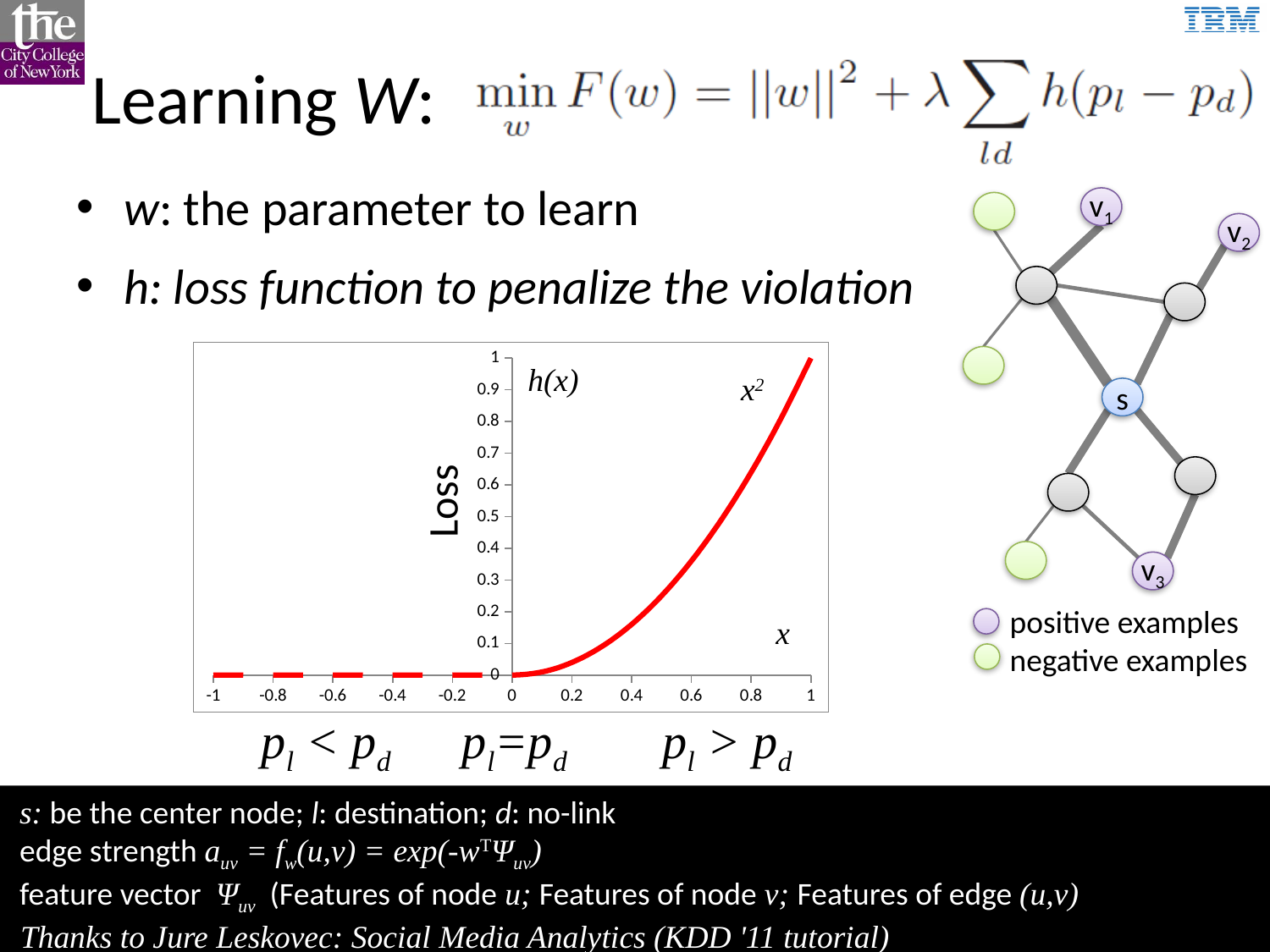
What is the value of h(x) at x = 0? 0 What kind of chart is shown on the slide? line chart Is the value of h(x) at x = 0.4 greater or less than 0.3? less Is the value of h(x) at x = 0.8 greater or less than 0.5? greater What is the value of h(x) at x = -0.6? 0 Which is larger, h(x) at x = 0.4 or h(x) at x = 0.8? x = 0.8 What is the value of h(x) at x = 1? 1 What colour is the plotted loss curve? red Is the value of h(x) at x = 0.6 greater or less than 0.5? less Does the loss curve rise or fall as x increases from 0 to 1? rise At which x value does the curve reach its highest point? 1 What is the label on the vertical axis of the chart? Loss